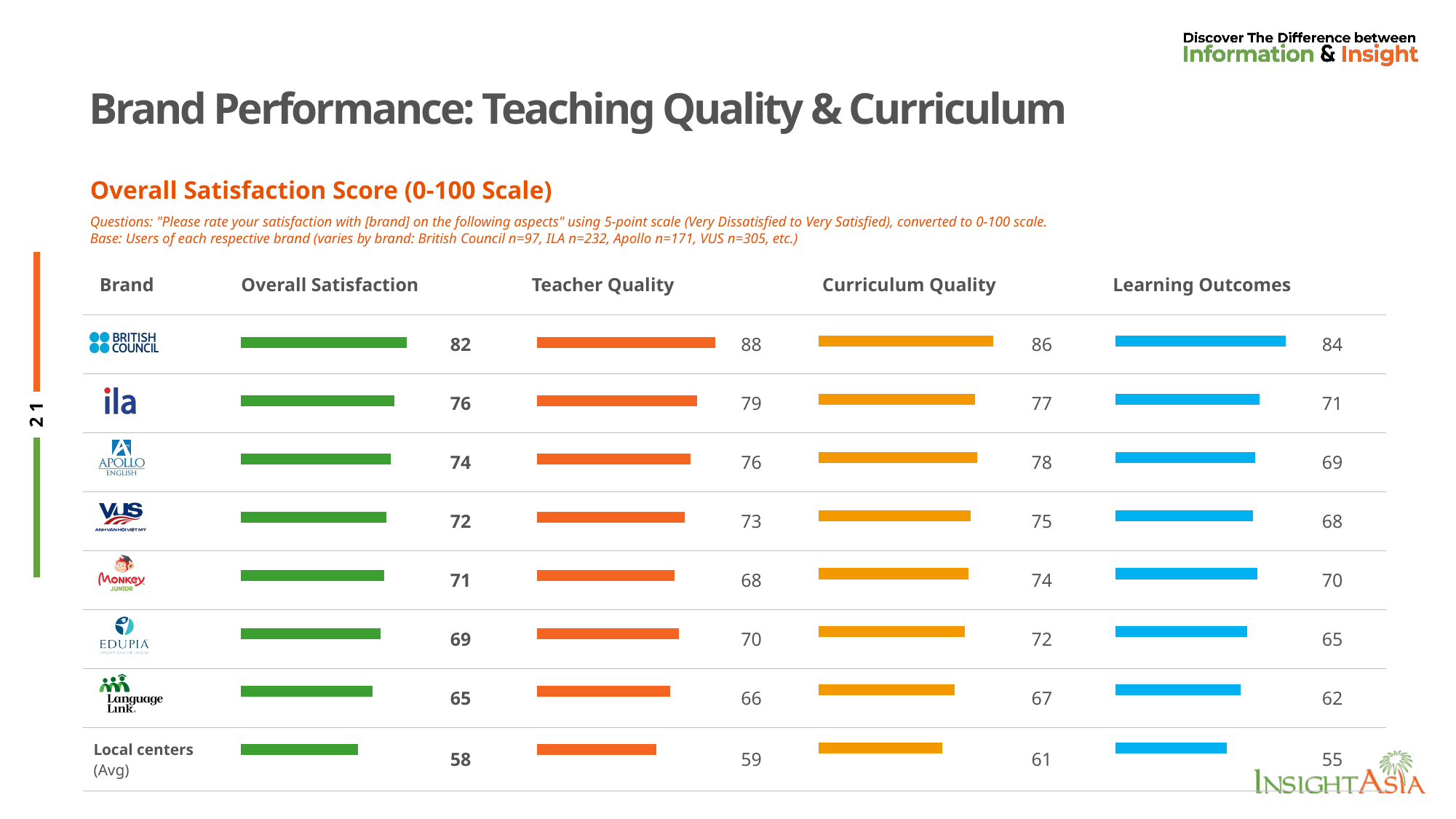
Which is higher for VUS: Teacher Quality or Curriculum Quality? Curriculum Quality What is the Curriculum Quality score for Apollo English? 78 What is the Teacher Quality score for ILA? 79 Which brand has the lowest Overall Satisfaction score? Local centers (Avg) How many brands (rows) are shown in the chart? 8 What is the Learning Outcomes score for Local centers (Avg)? 55 What is the difference between British Council's and ILA's Overall Satisfaction scores? 6 Which brand has the highest Teacher Quality score? British Council What is the Overall Satisfaction score for British Council? 82 What is the title of the chart? Overall Satisfaction Score (0-100 Scale) How many score columns (aspects) are shown in the chart? 4 What kind of chart is used to show the scores? Bar chart